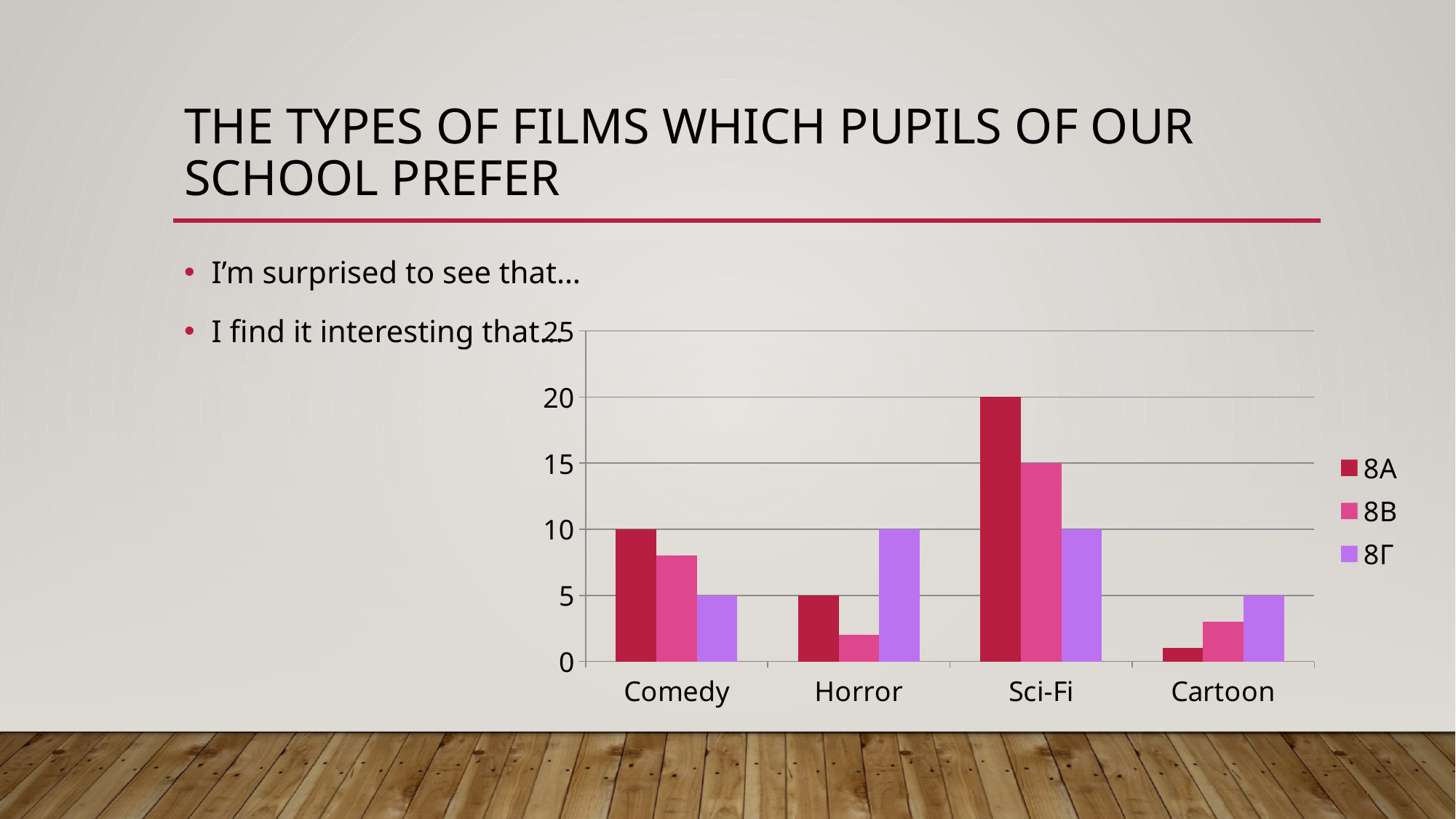
What kind of chart is shown on the slide? bar chart Is the value for 8B in the Comedy category greater or less than 5? greater How many film categories are shown on the x axis? 4 Which is larger in the Horror category, the value for 8A or the value for 8Г? 8Г What is the value for 8A in the Comedy category? 10 Which film category has the highest value for 8A? Sci-Fi What is the value for 8Г in the Horror category? 10 Which film category has the lowest value for 8A? Cartoon What is the value for 8A in the Sci-Fi category? 20 How many series does the legend list? 3 What is the value for 8B in the Sci-Fi category? 15 What is the difference between the 8A and 8B values in the Sci-Fi category? 5